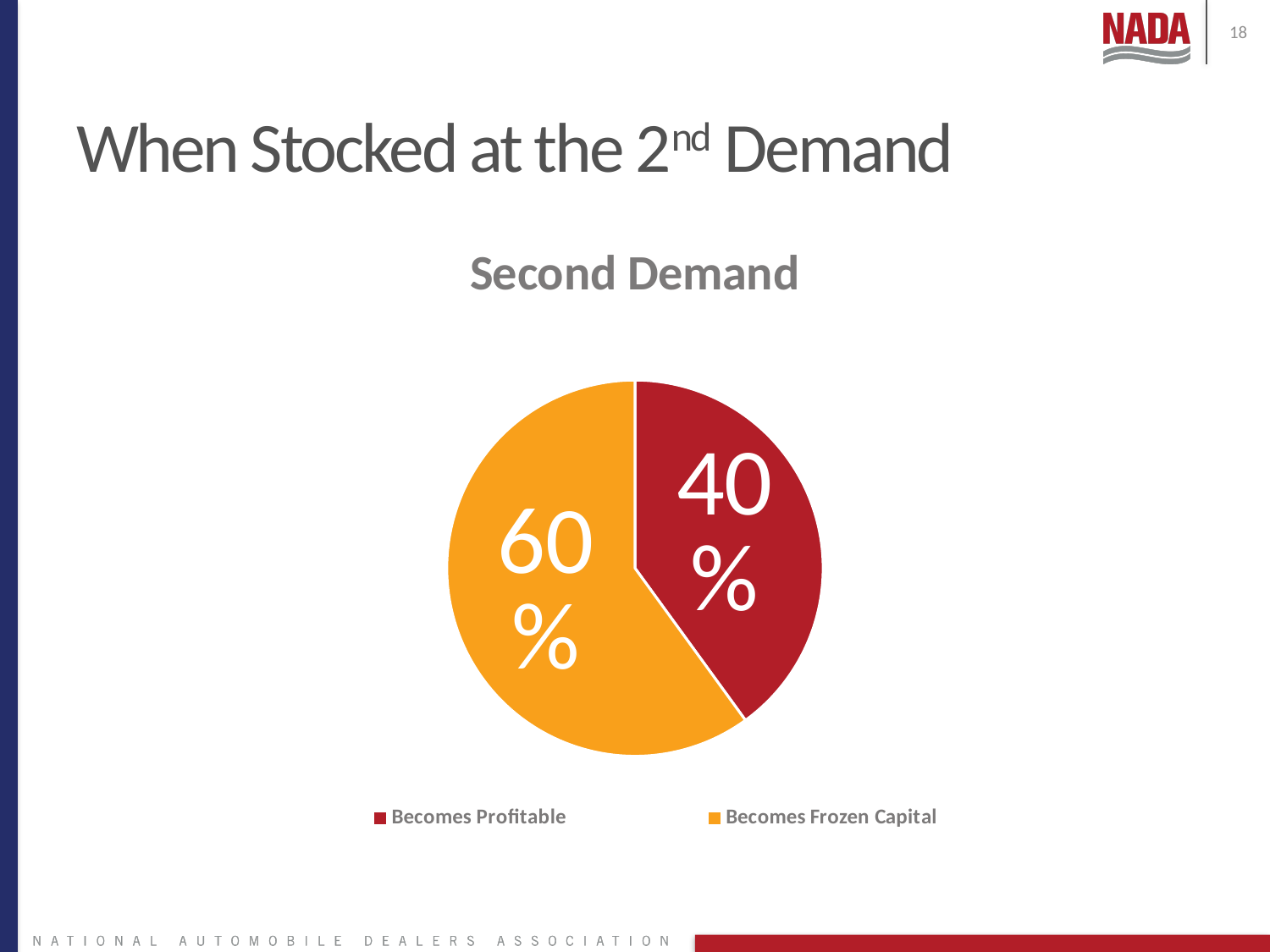
How many slices does the pie chart have? 2 Which is larger, Becomes Profitable or Becomes Frozen Capital? Becomes Frozen Capital What colour is the Becomes Profitable slice? red Which slice is the smallest? Becomes Profitable What share of the pie does Becomes Frozen Capital represent? 60% What is the title of the chart? Second Demand What type of chart is shown on the slide? pie chart Which slice is the largest? Becomes Frozen Capital What share of the pie does Becomes Profitable represent? 40% What is the difference in percentage points between Becomes Frozen Capital and Becomes Profitable? 20 How many entries does the legend list? 2